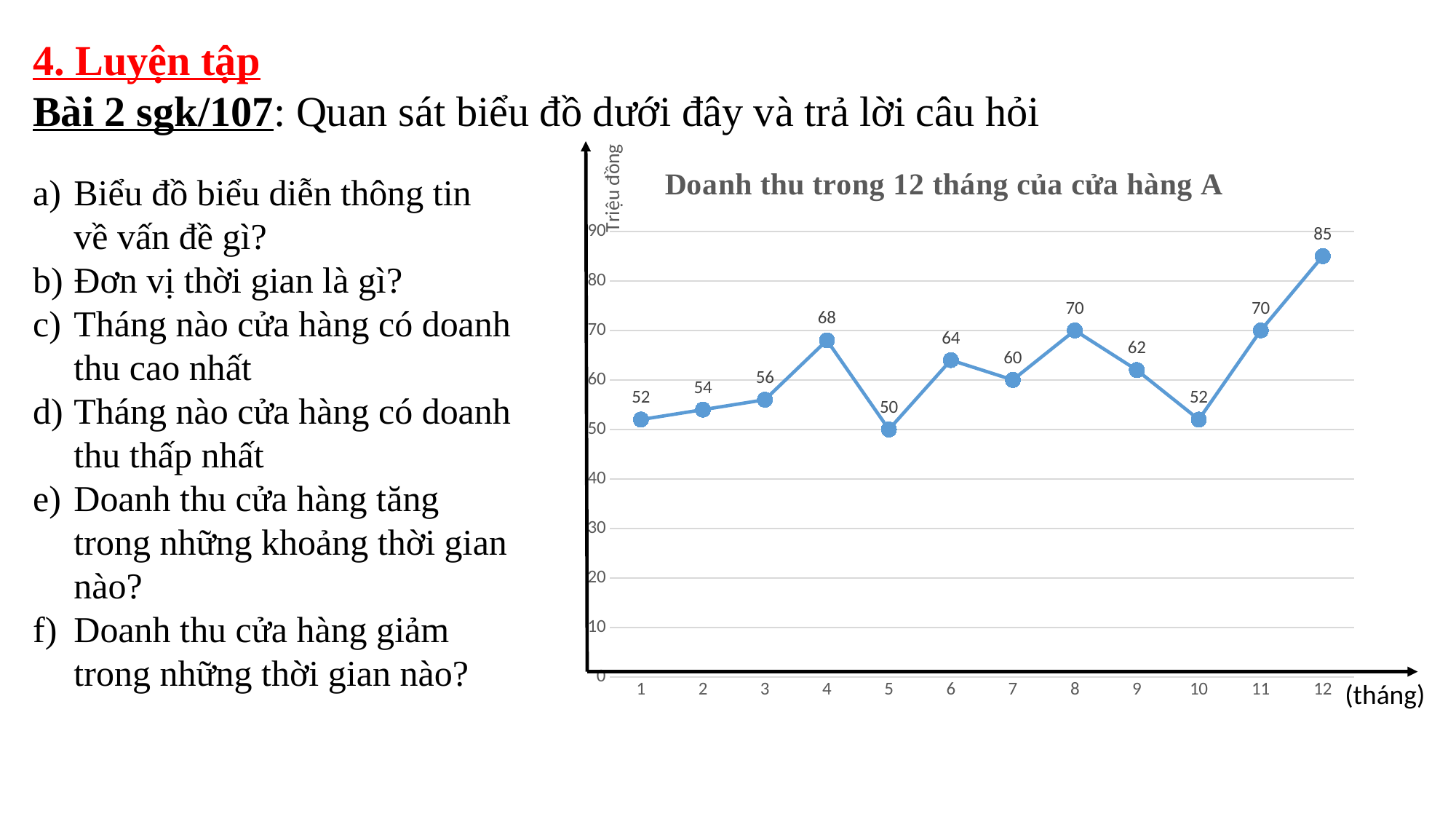
What is the difference between the revenue in month 4 and month 5? 18 Which month has the lowest revenue? 5 What is the revenue for month 8? 70 What kind of chart is shown on the slide? line chart What is the difference between the revenue in month 12 and month 11? 15 What is the revenue for month 5? 50 How many months are plotted on the chart? 12 Which is larger, the revenue in month 6 or month 7? month 6 Which month has the highest revenue? 12 What is the revenue for month 12? 85 What is the title of the chart? Doanh thu trong 12 tháng của cửa hàng A Is the revenue for month 9 greater or less than 70? less